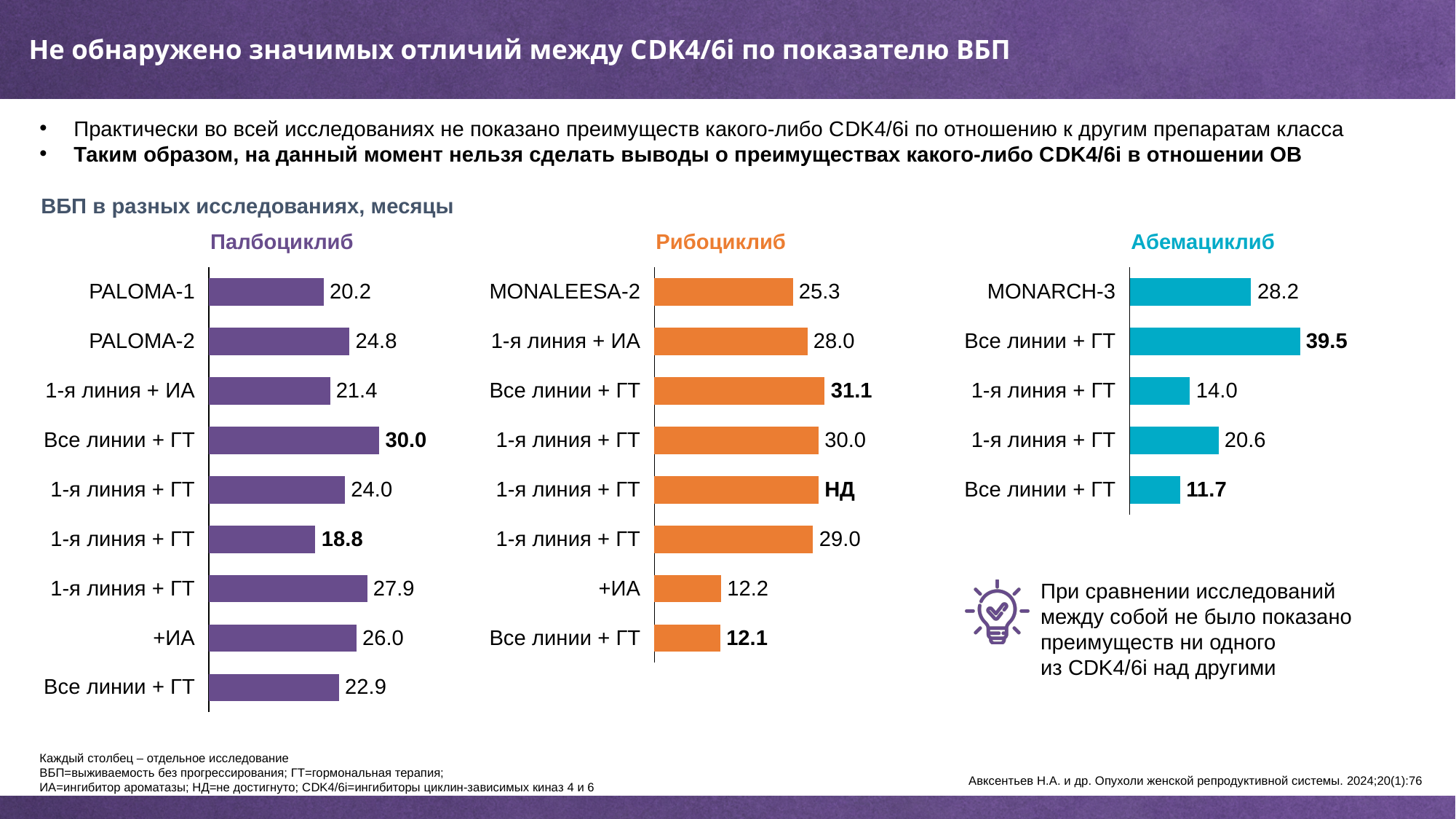
In the Палбоциклиб chart, what is the value for PALOMA-1? 20.2 How many bars does the Абемациклиб chart have? 5 In the Рибоциклиб chart, what is the lowest value shown? 12.1 In the Рибоциклиб chart, what is the value for +ИА? 12.2 What kind of chart is the Палбоциклиб chart? Bar chart In the Палбоциклиб chart, what is the lowest value shown? 18.8 In the Палбоциклиб chart, what is the value for PALOMA-2? 24.8 In the Абемациклиб chart, what is the highest value shown? 39.5 In the Рибоциклиб chart, what is the value for MONALEESA-2? 25.3 In the Палбоциклиб chart, what is the difference between PALOMA-2 and PALOMA-1? 4.6 In the Абемациклиб chart, what is the value for MONARCH-3? 28.2 Which is larger: PALOMA-1 in the Палбоциклиб chart or MONALEESA-2 in the Рибоциклиб chart? MONALEESA-2